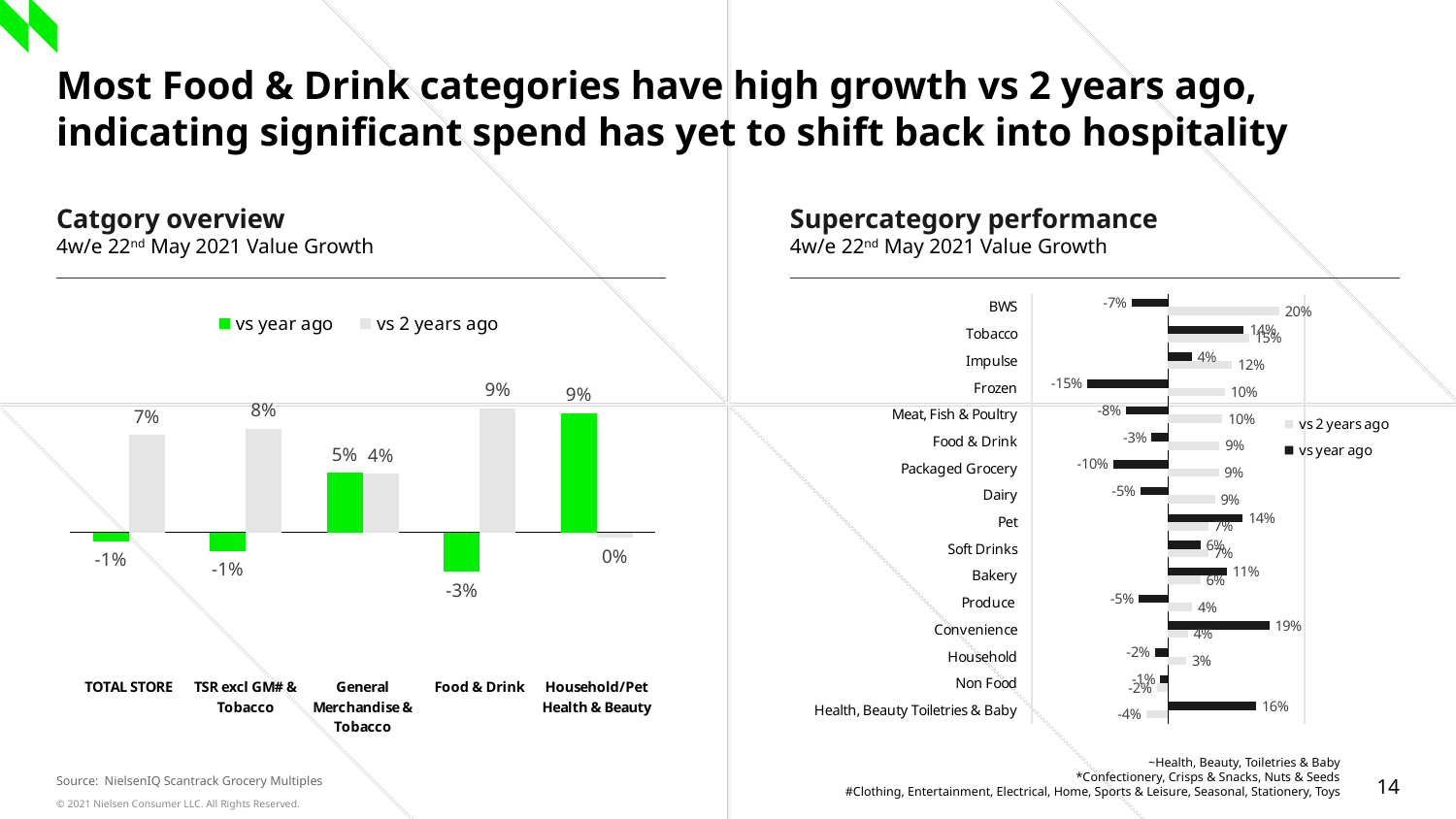
How many series does the legend of the Catgory overview chart list? 2 In the Catgory overview chart, what is the difference between the vs 2 years ago and vs year ago values for TOTAL STORE? 8 percentage points In the Supercategory performance chart, which is larger: the vs year ago value for Convenience or for Pet? Convenience In the Supercategory performance chart, which category has the lowest vs year ago value? Frozen In the Catgory overview chart, what is the value for Food & Drink vs year ago? -3% In the Supercategory performance chart, what is the vs year ago value for Frozen? -15% In the Catgory overview chart, what is the value for TSR excl GM# & Tobacco vs 2 years ago? 8% In the Catgory overview chart, which category has the highest vs year ago value? Household/Pet Health & Beauty In the Supercategory performance chart, what is the difference between the vs year ago and vs 2 years ago values for Health, Beauty Toiletries & Baby? 20 percentage points What kind of chart is the Supercategory performance chart? Bar chart How many categories are shown in the Supercategory performance chart? 16 In the Supercategory performance chart, what is the vs 2 years ago value for BWS? 20%